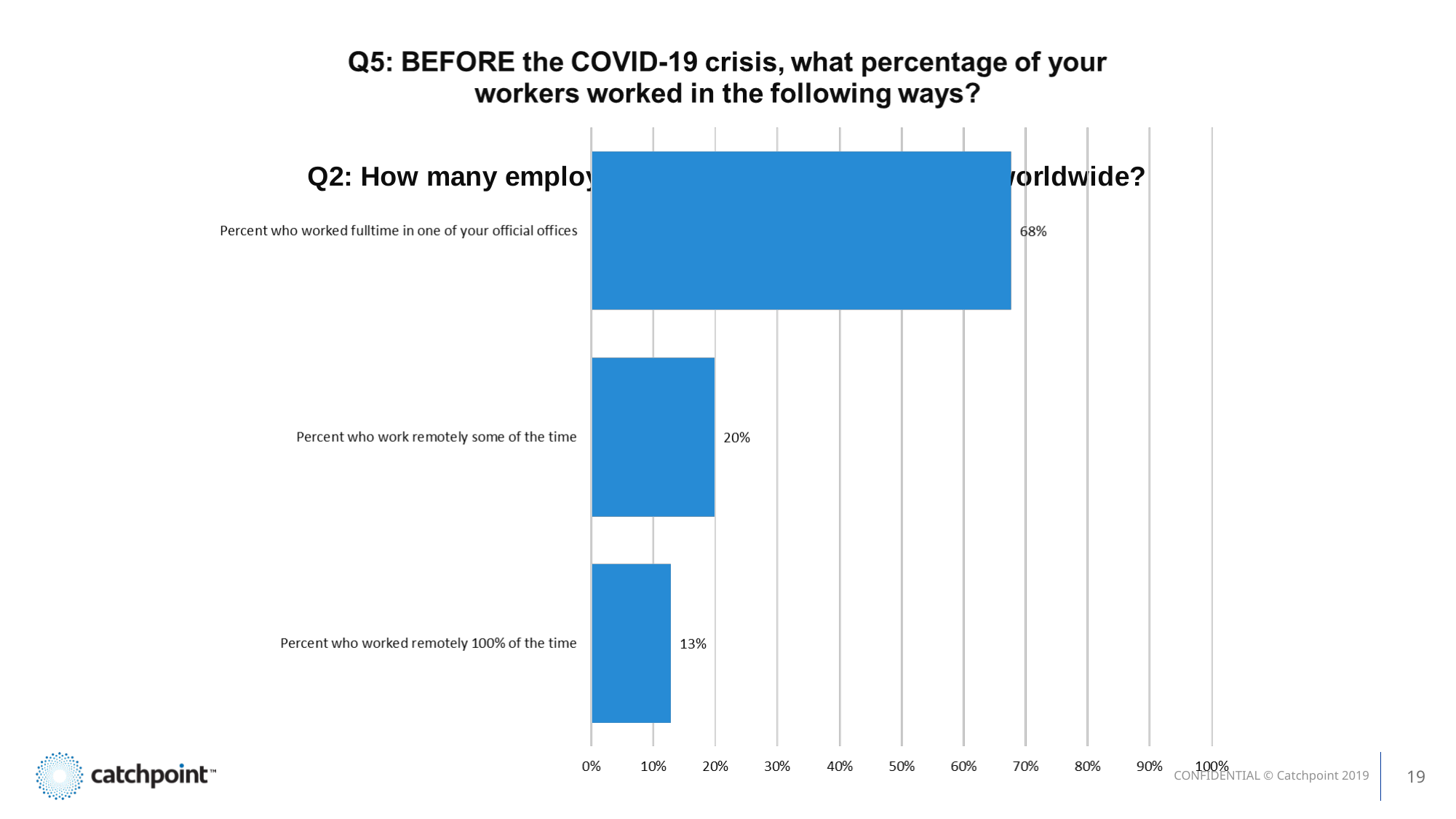
What is the difference between the percentage who worked fulltime in an official office and the percentage who worked remotely some of the time? 48% What is the maximum value shown on the percentage axis? 100% Is the value for workers who worked fulltime in an official office greater or less than 60%? greater Which is larger: the percentage who worked remotely some of the time or the percentage who worked remotely 100% of the time? Percent who work remotely some of the time What percentage of workers worked remotely some of the time? 20% What percentage of workers worked fulltime in one of the official offices before the COVID-19 crisis? 68% Which category has the highest value? Percent who worked fulltime in one of your official offices What percentage of workers worked remotely 100% of the time? 13% What type of chart is shown on the slide? Bar chart What is the difference between the percentage who worked remotely some of the time and the percentage who worked remotely 100% of the time? 7% How many categories are shown in the chart? 3 Which category has the lowest value? Percent who worked remotely 100% of the time